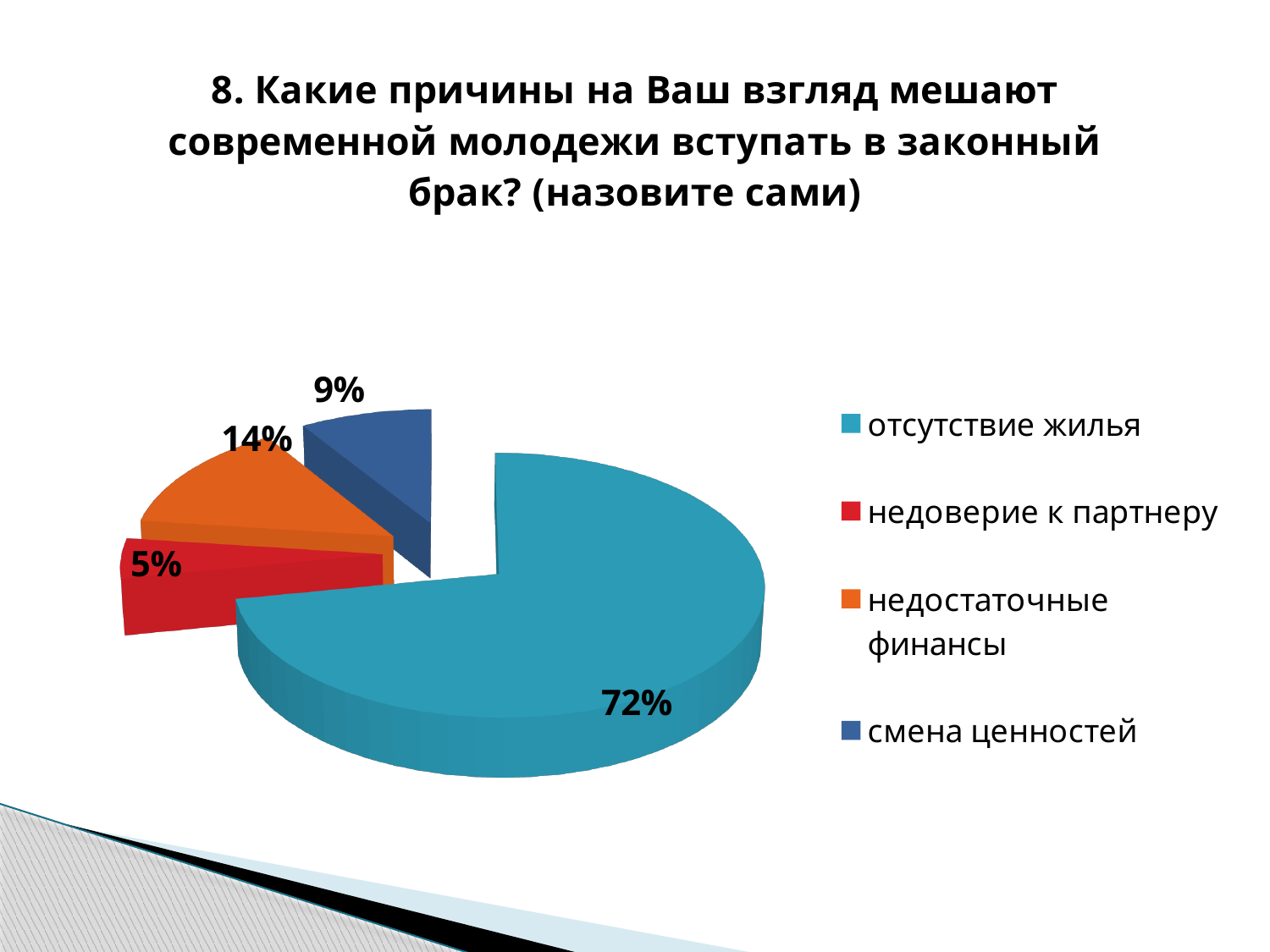
What percentage is shown for "недостаточные финансы"? 14% What is the difference in percentage points between "отсутствие жилья" and "недостаточные финансы"? 58 What percentage is shown for "недоверие к партнеру"? 5% What percentage is shown for "смена ценностей"? 9% How many categories does the pie chart show? 4 What colour is the slice for "недоверие к партнеру"? red Which category has the largest slice of the pie? отсутствие жилья Which category has the smallest slice of the pie? недоверие к партнеру What kind of chart is shown on the slide? pie chart What is the difference in percentage points between "смена ценностей" and "недоверие к партнеру"? 4 Which is larger: the slice for "недостаточные финансы" or the slice for "смена ценностей"? недостаточные финансы What percentage of the pie is labelled for "отсутствие жилья"? 72%